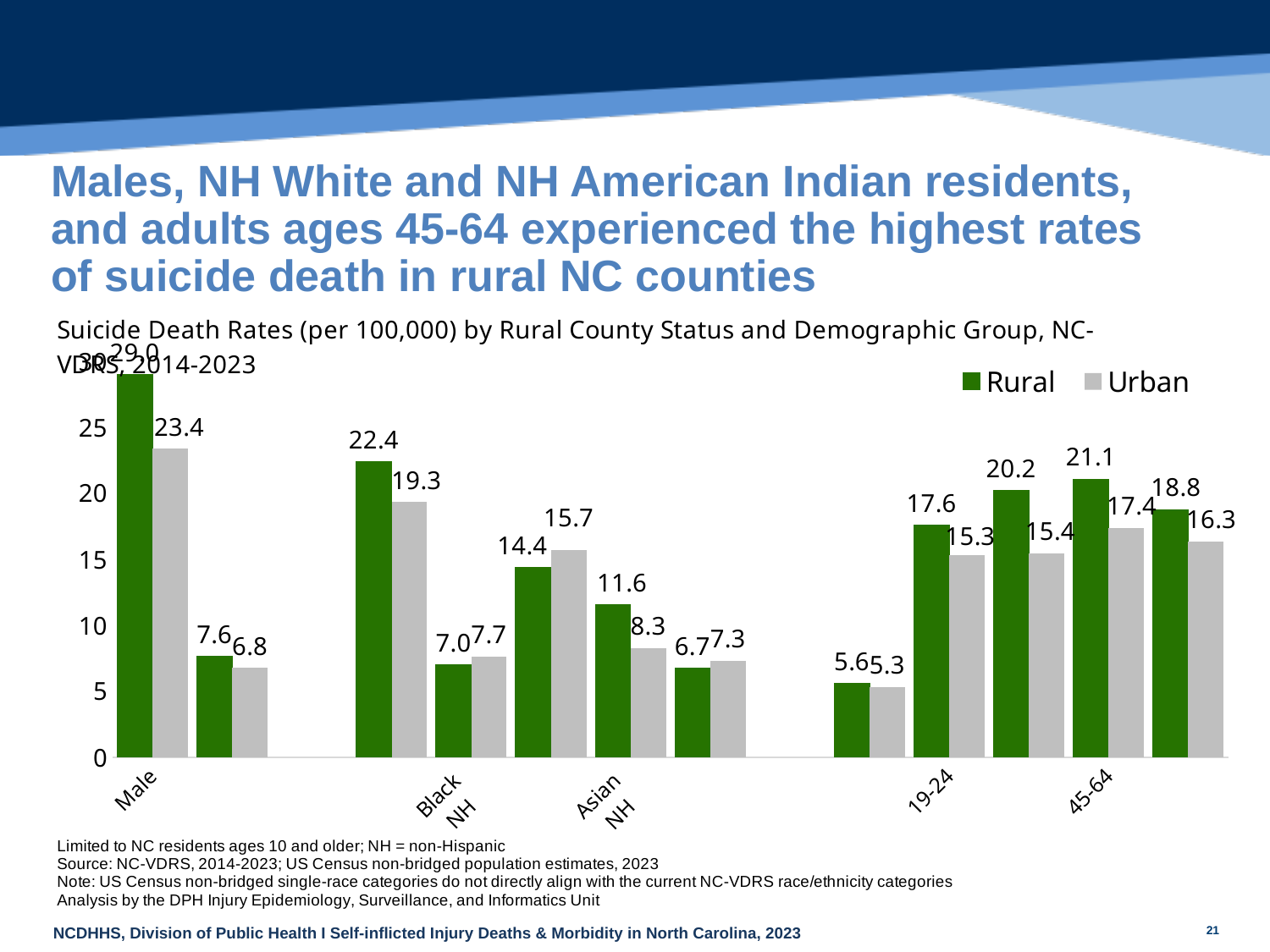
What is the difference between the rural and urban suicide death rates for Male residents? 5.6 What is the urban suicide death rate for ages 19-24? 15.3 Which is larger for Black NH residents, the rural rate or the urban rate? Urban What is the rural suicide death rate for Male residents? 29.0 How many series does the legend list? 2 Which is larger for ages 45-64, the rural rate or the urban rate? Rural What kind of chart is shown on the slide? Bar chart What is the rural suicide death rate for Black NH residents? 7.0 What is the urban suicide death rate for Asian NH residents? 8.3 Is the rural suicide death rate for Asian NH residents greater or less than 10? greater What is the rural suicide death rate for adults ages 45-64? 21.1 What is the urban suicide death rate for Male residents? 23.4